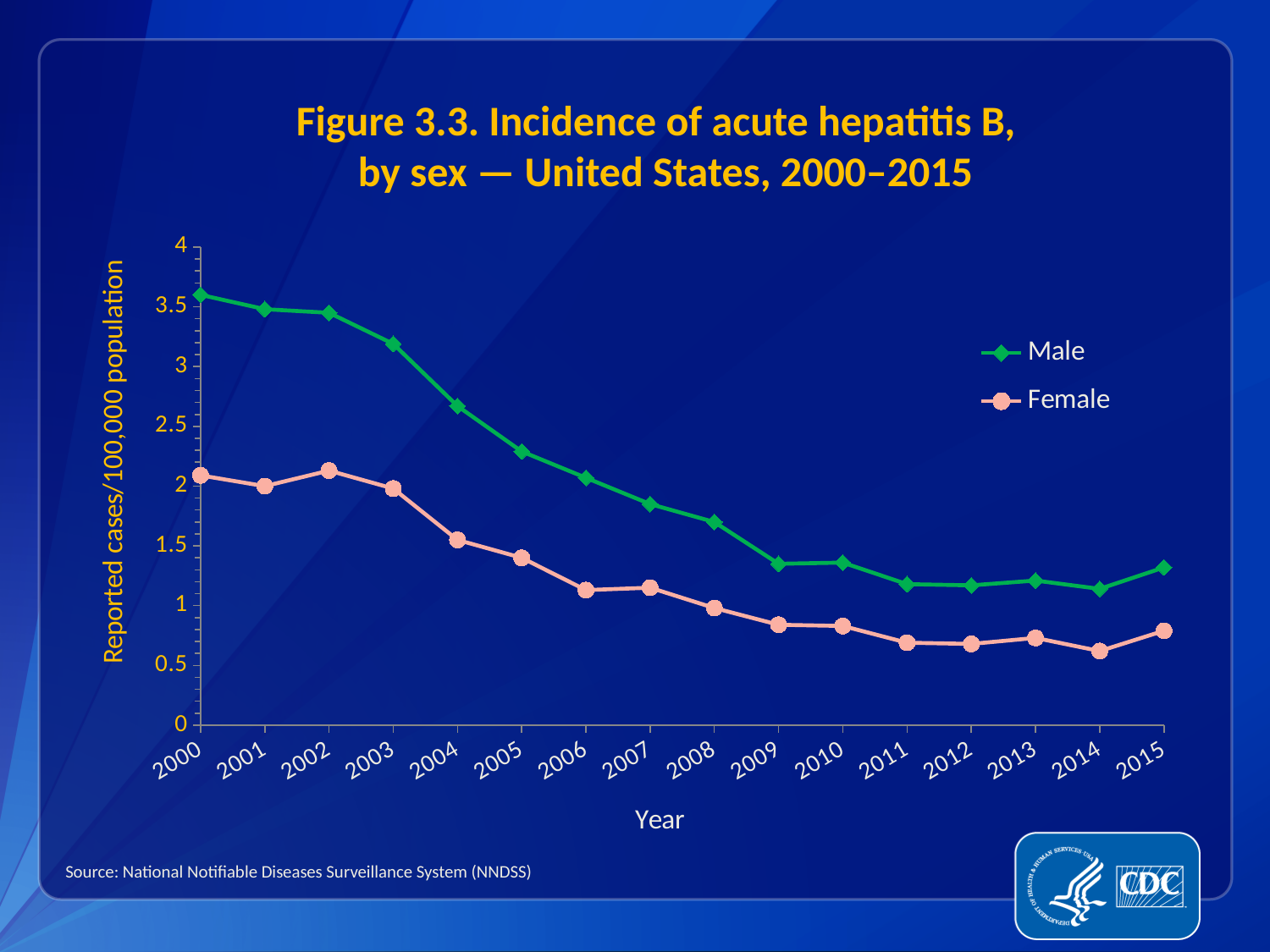
In which year is the Male incidence rate highest? 2000 Overall, do the Male incidence values rise or fall from 2000 to 2015? Fall What is the label on the y axis? Reported cases/100,000 population Is the Female value for 2011 greater or less than 1? less Is the Male value for 2004 greater or less than 2.5? greater What kind of chart is shown on the slide? Line chart In 2005, which series has the higher incidence rate, Male or Female? Male How many years are plotted along the x axis? 16 Is the Female value for 2014 greater or less than 1? less How many series does the legend list? 2